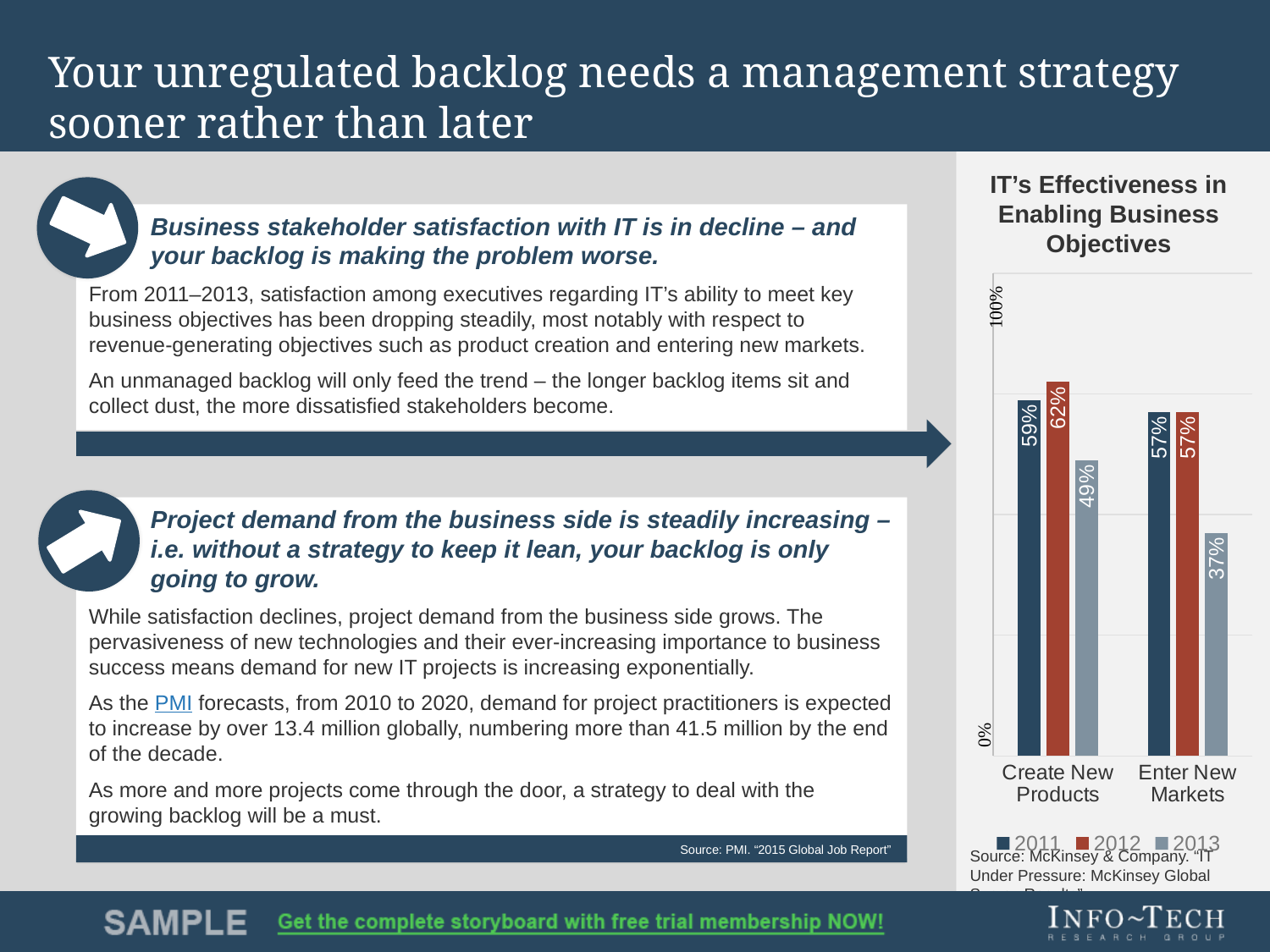
Which is larger: the 2013 value for Create New Products or the 2013 value for Enter New Markets? Create New Products What is the difference between the 2011 and 2013 values for Enter New Markets? 20% How many series does the chart's legend list? 3 How many categories are shown on the x axis of the chart? 2 What is the title of the chart on the slide? IT's Effectiveness in Enabling Business Objectives What is the value for 2013 in the Enter New Markets category? 37% What is the value for 2011 in the Create New Products category? 59% What kind of chart is shown on the slide? Bar chart What is the value for 2012 in the Create New Products category? 62% Which year has the lowest value in the Enter New Markets category? 2013 What is the difference between the 2012 and 2013 values for Create New Products? 13% Which year has the highest value in the Create New Products category? 2012